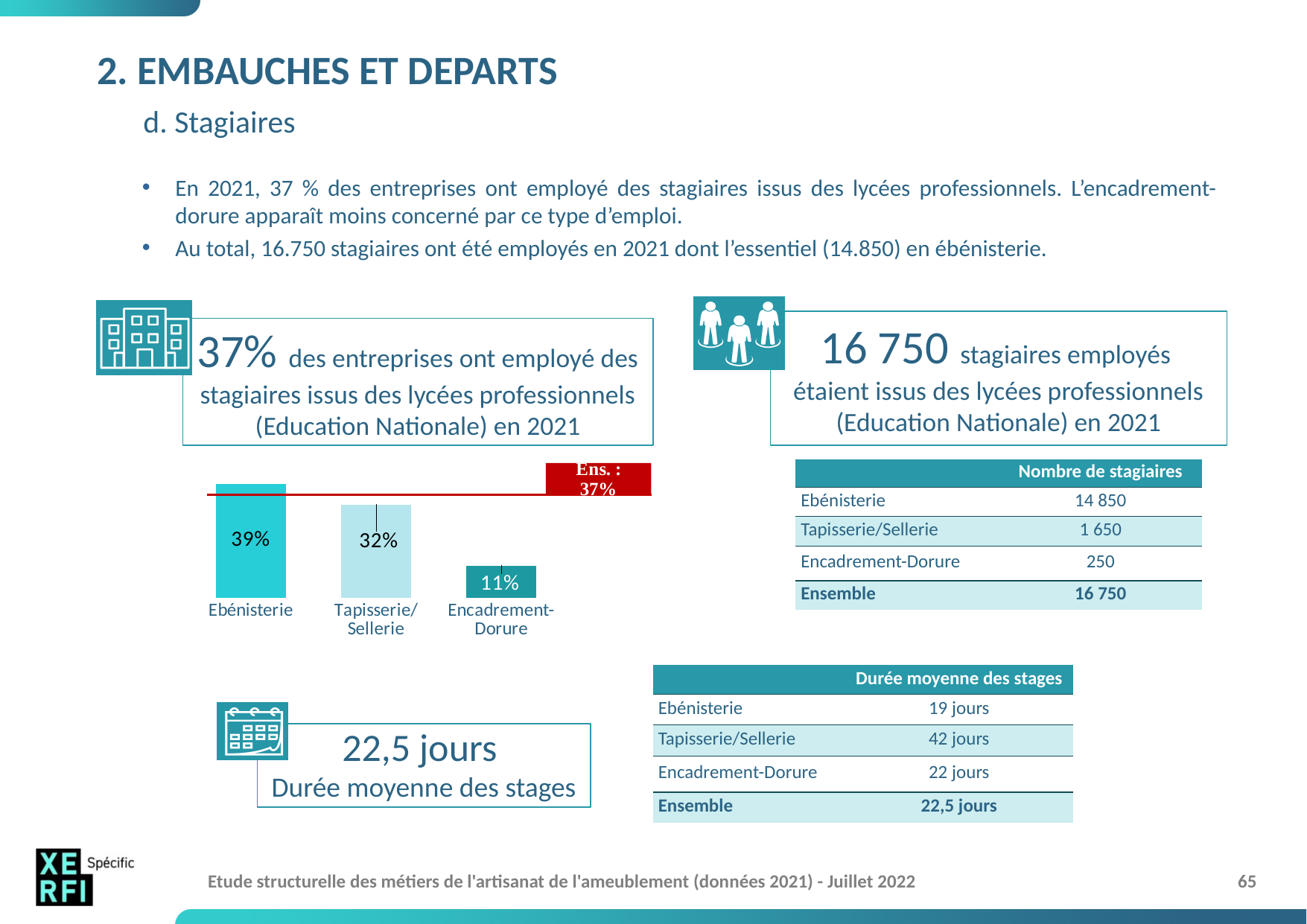
What kind of chart is shown on the slide? bar chart In the bar chart, what is the value for Tapisserie/Sellerie? 32% Do the values in the bar chart rise or fall from left to right? fall How many categories does the bar chart show? 3 In the bar chart, what is the value for Ebénisterie? 39% In the bar chart, what is the difference between the values for Ebénisterie and Tapisserie/Sellerie? 7% In the bar chart, which category has the lowest value? Encadrement-Dorure In the bar chart, which category has the highest value? Ebénisterie In the bar chart, what is the difference between the values for Tapisserie/Sellerie and Encadrement-Dorure? 21% In the bar chart, which is larger, the value for Tapisserie/Sellerie or the value for Encadrement-Dorure? Tapisserie/Sellerie In the bar chart, what is the value for Encadrement-Dorure? 11% What value does the red reference line labelled "Ens." in the bar chart indicate? 37%